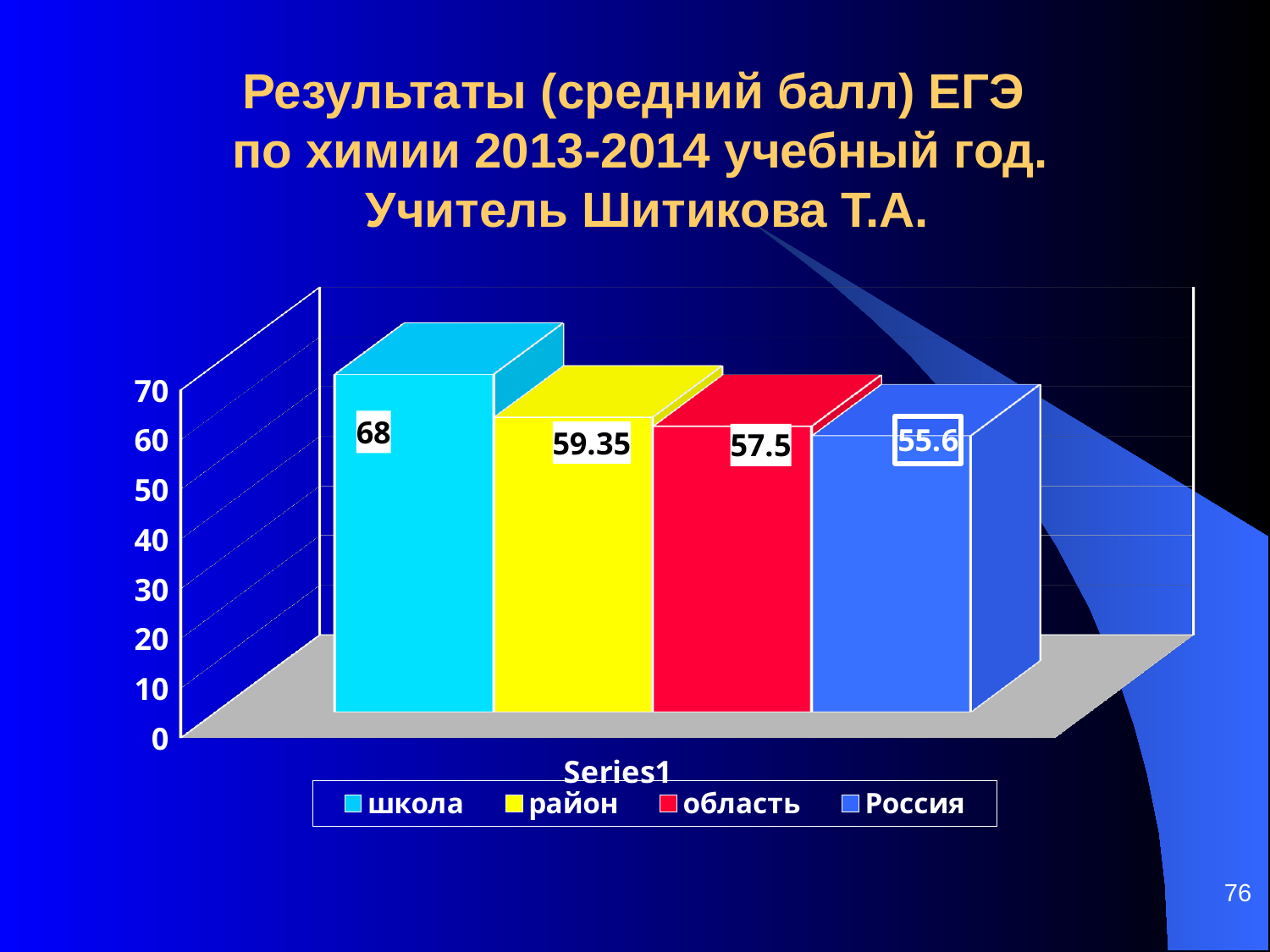
What is the difference between the values for район and область? 1.85 What is the value for Россия? 55.6 How many bars are shown in the chart? 4 How many entries does the legend list? 4 What kind of chart is shown on the slide? bar chart What is the value for район? 59.35 Which category has the highest value? школа What is the value for область? 57.5 What is the difference between the values for школа and Россия? 12.4 Which is larger, the value for область or the value for Россия? область Which category has the lowest value? Россия What is the value for школа? 68